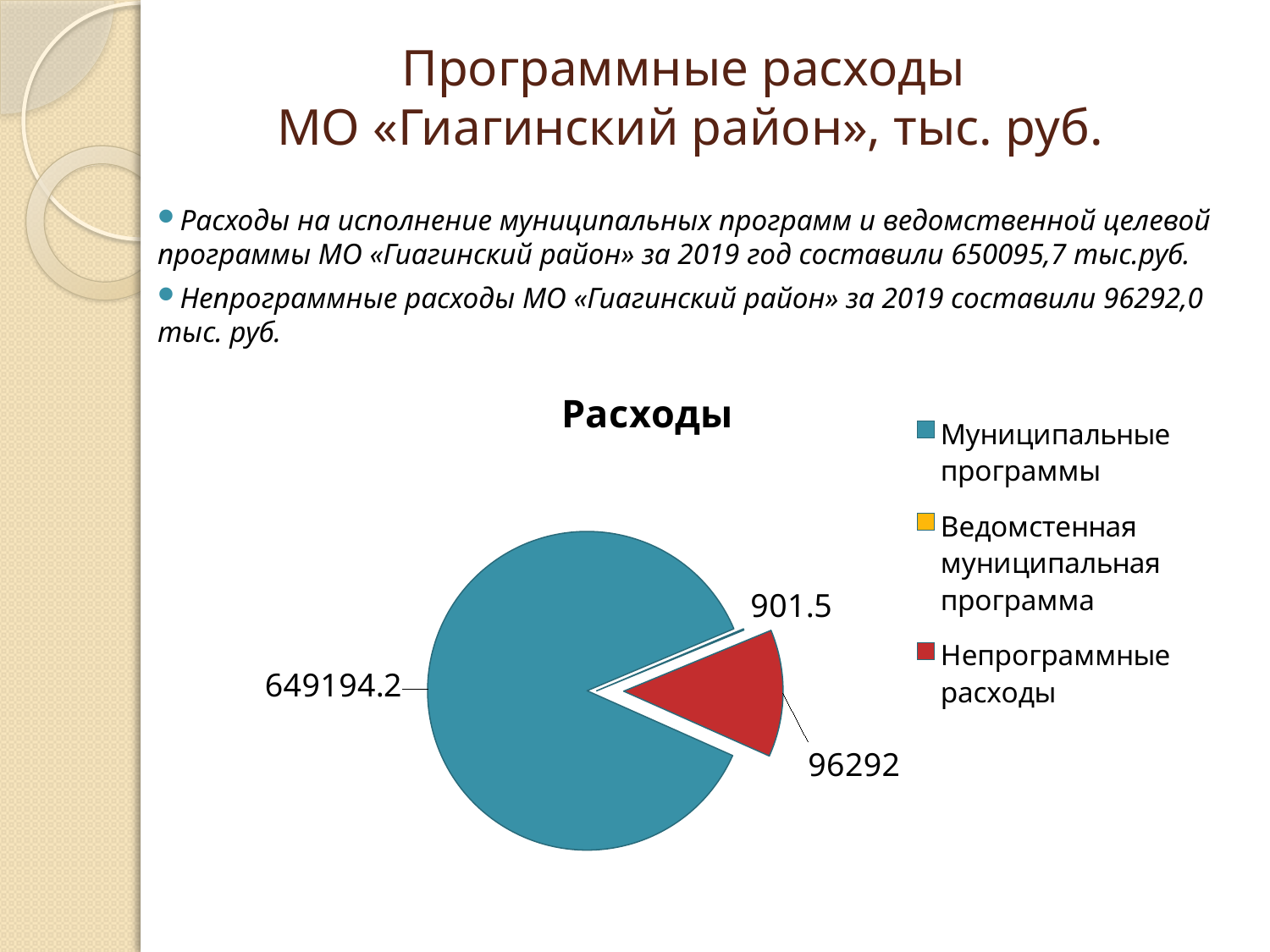
What is the value for Ведомстенная муниципальная программа in the pie chart? 901.5 What colour is the slice for Непрограммные расходы? Red How many categories does the legend of the pie chart list? 3 Which category has the smallest slice in the pie chart? Ведомстенная муниципальная программа What is the title of the chart? Расходы Which category has the largest slice in the pie chart? Муниципальные программы What is the value for Непрограммные расходы in the pie chart? 96292 What is the value for Муниципальные программы in the pie chart? 649194.2 How many slices does the pie chart have? 3 What type of chart is shown on the slide? Pie chart What is the difference between the values for Муниципальные программы and Непрограммные расходы? 552902.2 Which is larger: Непрограммные расходы or Ведомстенная муниципальная программа? Непрограммные расходы